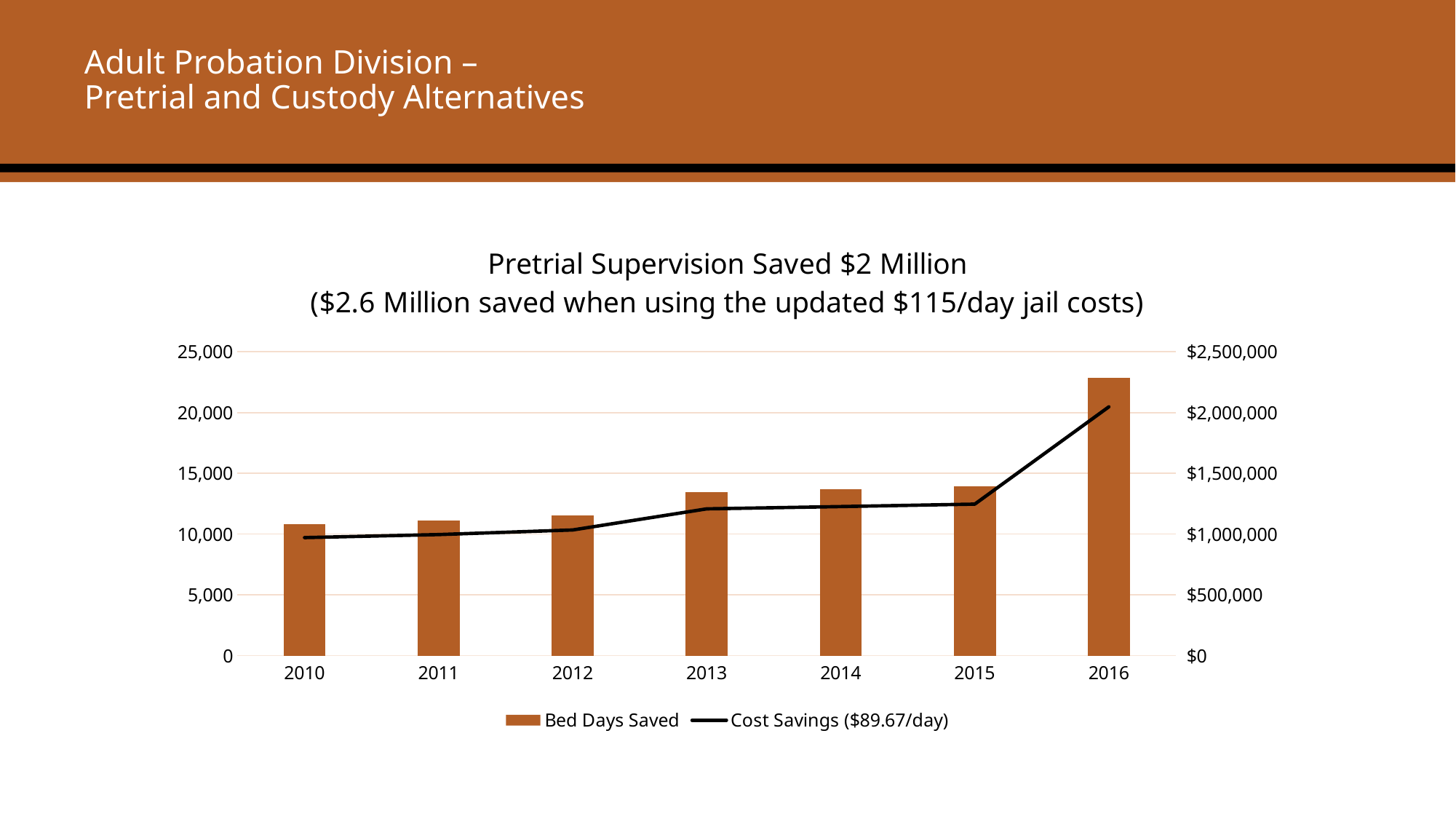
How many series does the chart legend list? 2 Is the value for Bed Days Saved in 2010 greater or less than 15,000? less Is the Cost Savings ($89.67/day) value for 2016 greater or less than $1,500,000? greater Which year has more Bed Days Saved, 2012 or 2013? 2013 How many years are shown on the x axis of the chart? 7 Is the value for Bed Days Saved in 2016 greater or less than 20,000? greater What kind of chart is shown on the slide? Combined bar and line chart Which year has the highest number of Bed Days Saved? 2016 Which year has the lowest number of Bed Days Saved? 2010 What is the daily rate named in the legend entry for the Cost Savings line? $89.67/day Do the Bed Days Saved values rise or fall from 2010 to 2016? Rise